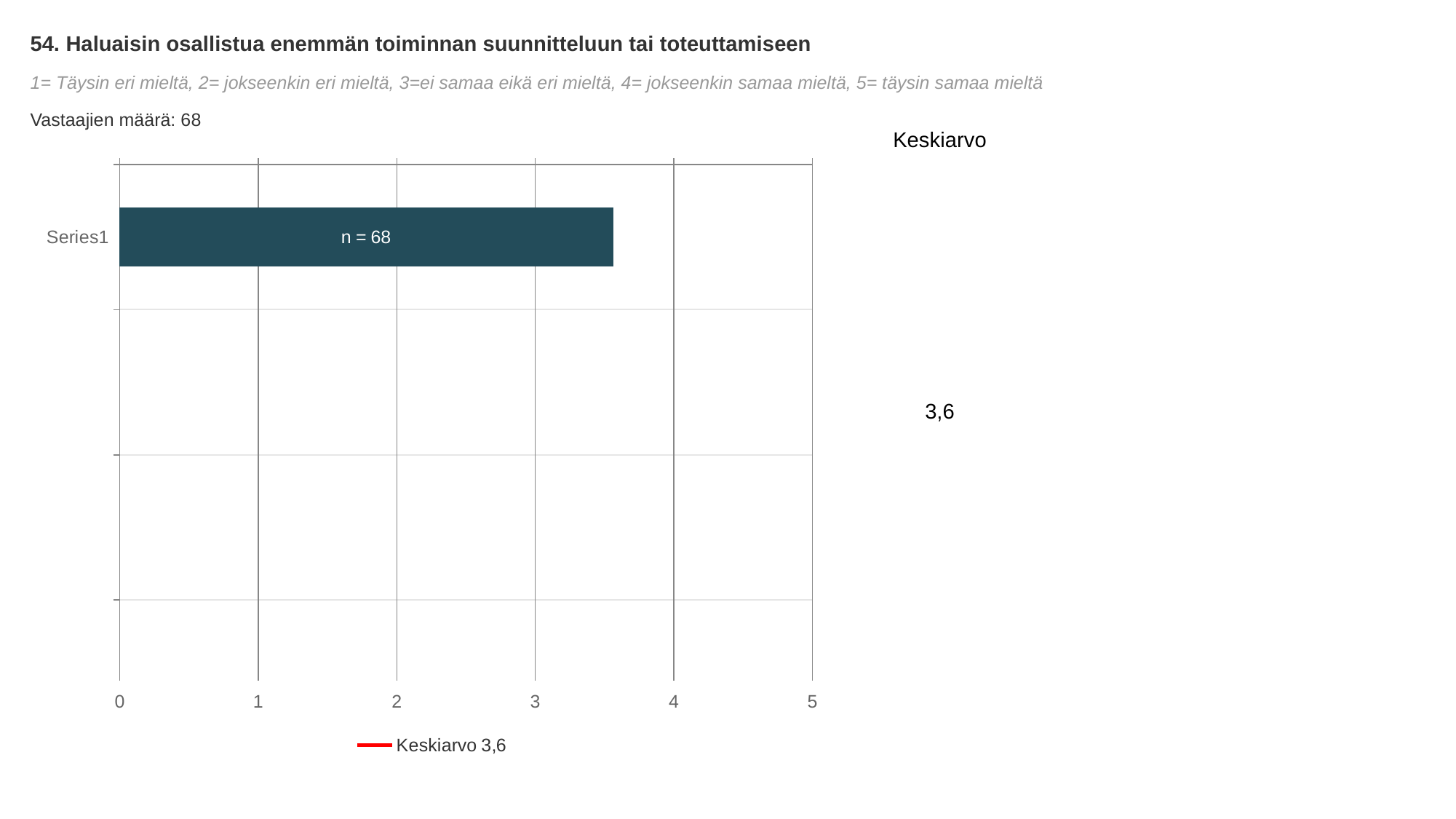
How many bars are plotted in the chart? 1 What does the legend entry below the chart say? Keskiarvo 3,6 Is the value for Series1 greater or less than 4? less Is the value for Series1 greater or less than 3? greater How many respondents (Vastaajien määrä) are reported on the slide? 68 What is the Keskiarvo (mean) value shown on the slide? 3,6 What is the highest value shown on the horizontal axis? 5 What kind of chart is shown on the slide? bar chart What data label is printed on the Series1 bar? n = 68 What is the category label of the single bar in the chart? Series1